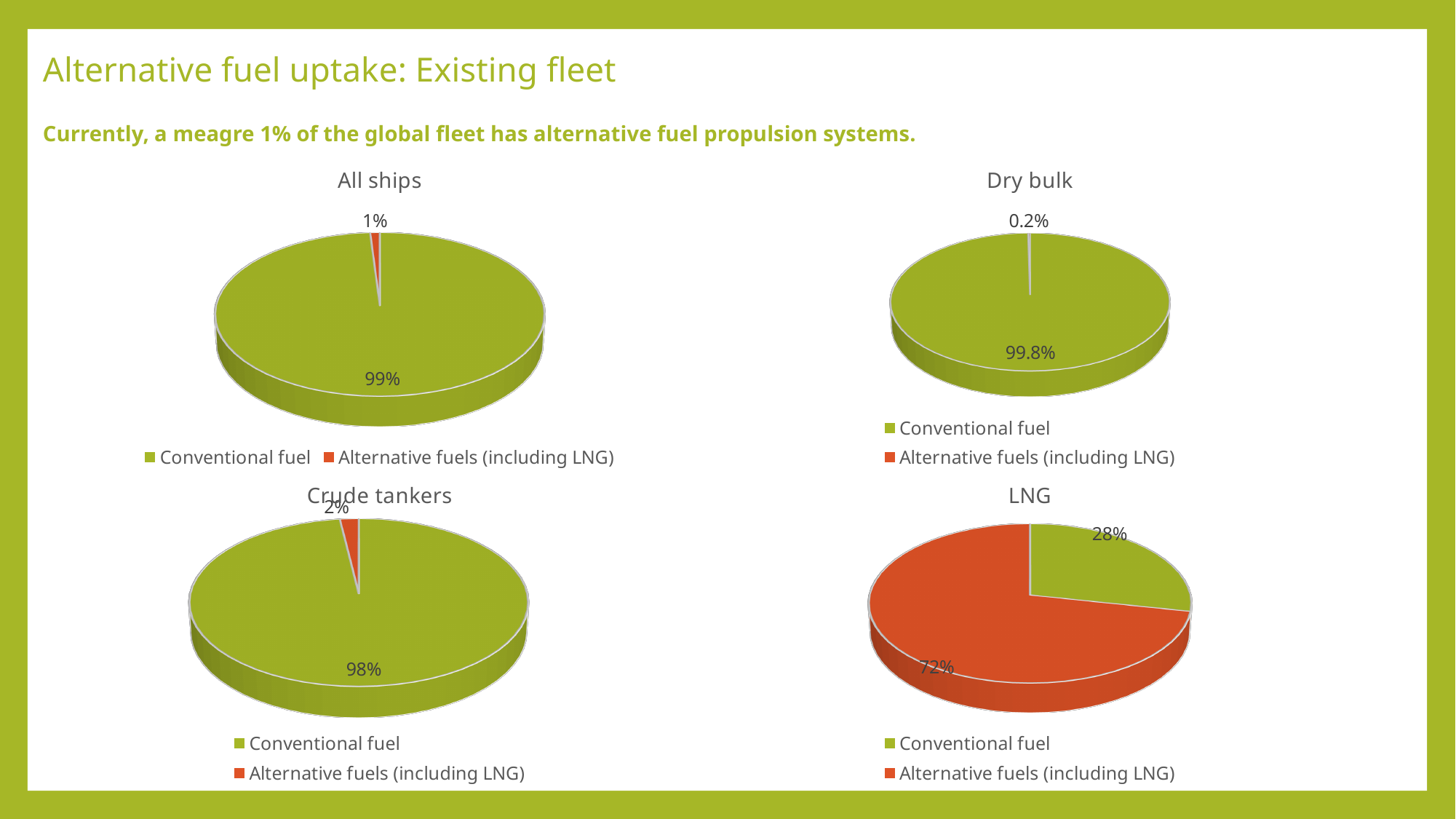
In the 'Crude tankers' chart, what is the value for Conventional fuel? 98% In the 'Crude tankers' chart, what is the value for Alternative fuels (including LNG)? 2% In the 'All ships' chart, what is the value for Conventional fuel? 99% In the 'Dry bulk' chart, what share of the pie is Conventional fuel? 99.8% In the 'LNG' chart, what share of the pie is Alternative fuels (including LNG)? 72% In the 'LNG' chart, which slice is larger, Conventional fuel or Alternative fuels (including LNG)? Alternative fuels (including LNG) In the 'LNG' chart, what is the value for Conventional fuel? 28% In the 'All ships' chart, what share of the pie is Alternative fuels (including LNG)? 1% What kind of chart is the 'Dry bulk' chart? Pie chart In the 'Dry bulk' chart, what is the value for Alternative fuels (including LNG)? 0.2% In the 'LNG' chart, what is the difference between the Alternative fuels (including LNG) share and the Conventional fuel share? 44% How many entries does the legend of the 'Crude tankers' chart list? 2